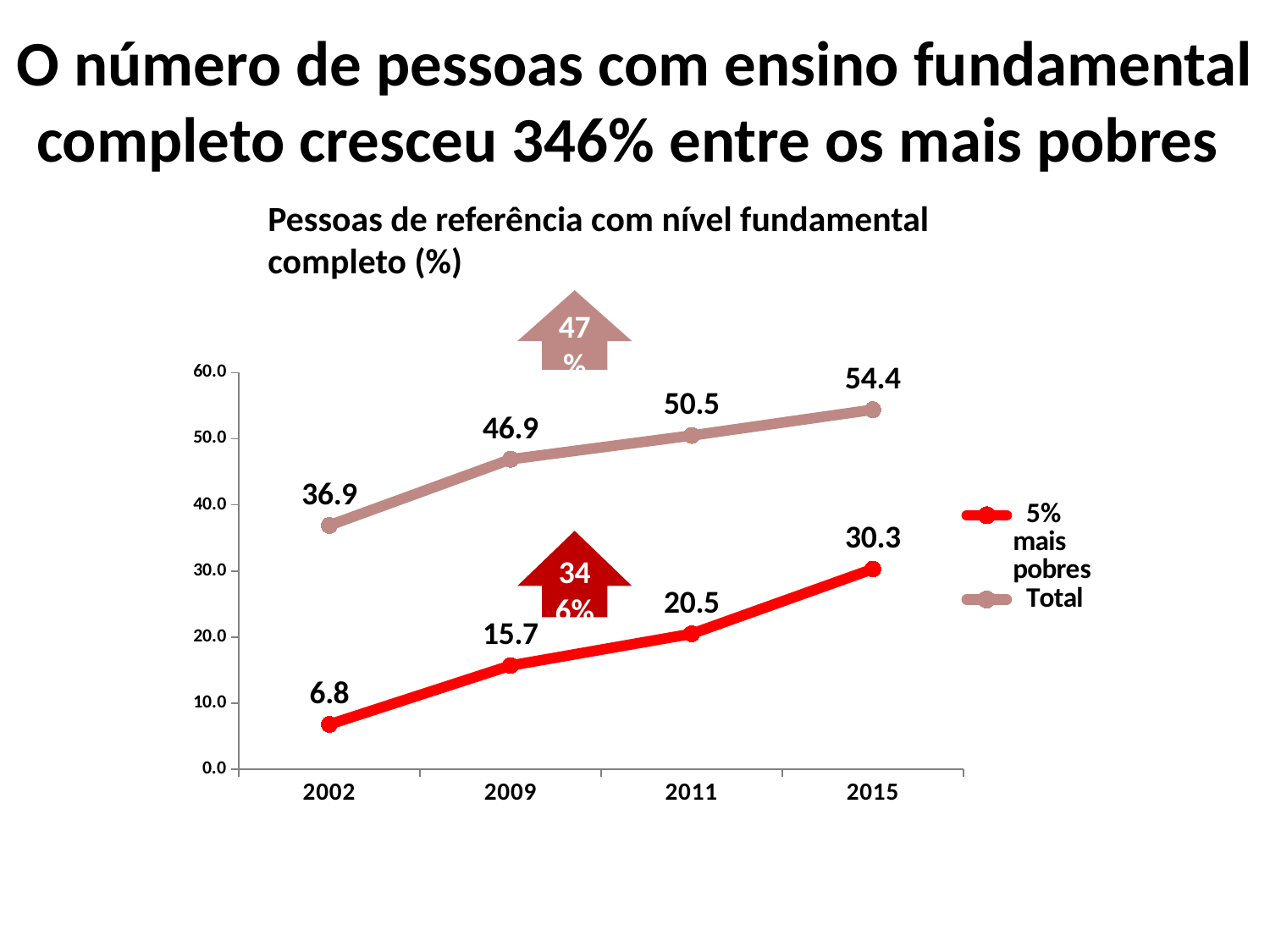
What kind of chart is shown on the slide? Line chart Which series has the larger value in 2009, '5% mais pobres' or 'Total'? Total What is the difference between the 'Total' and '5% mais pobres' values in 2015? 24.1 What is the value for the '5% mais pobres' series in 2002? 6.8 What is the value for the 'Total' series in 2015? 54.4 What is the value for the '5% mais pobres' series in 2011? 20.5 In which year is the 'Total' series lowest? 2002 How many series does the legend list? 2 Do the values for the '5% mais pobres' series rise or fall from 2002 to 2015? Rise What is the value for the 'Total' series in 2009? 46.9 How many years are plotted on the x axis? 4 In which year is the '5% mais pobres' series highest? 2015